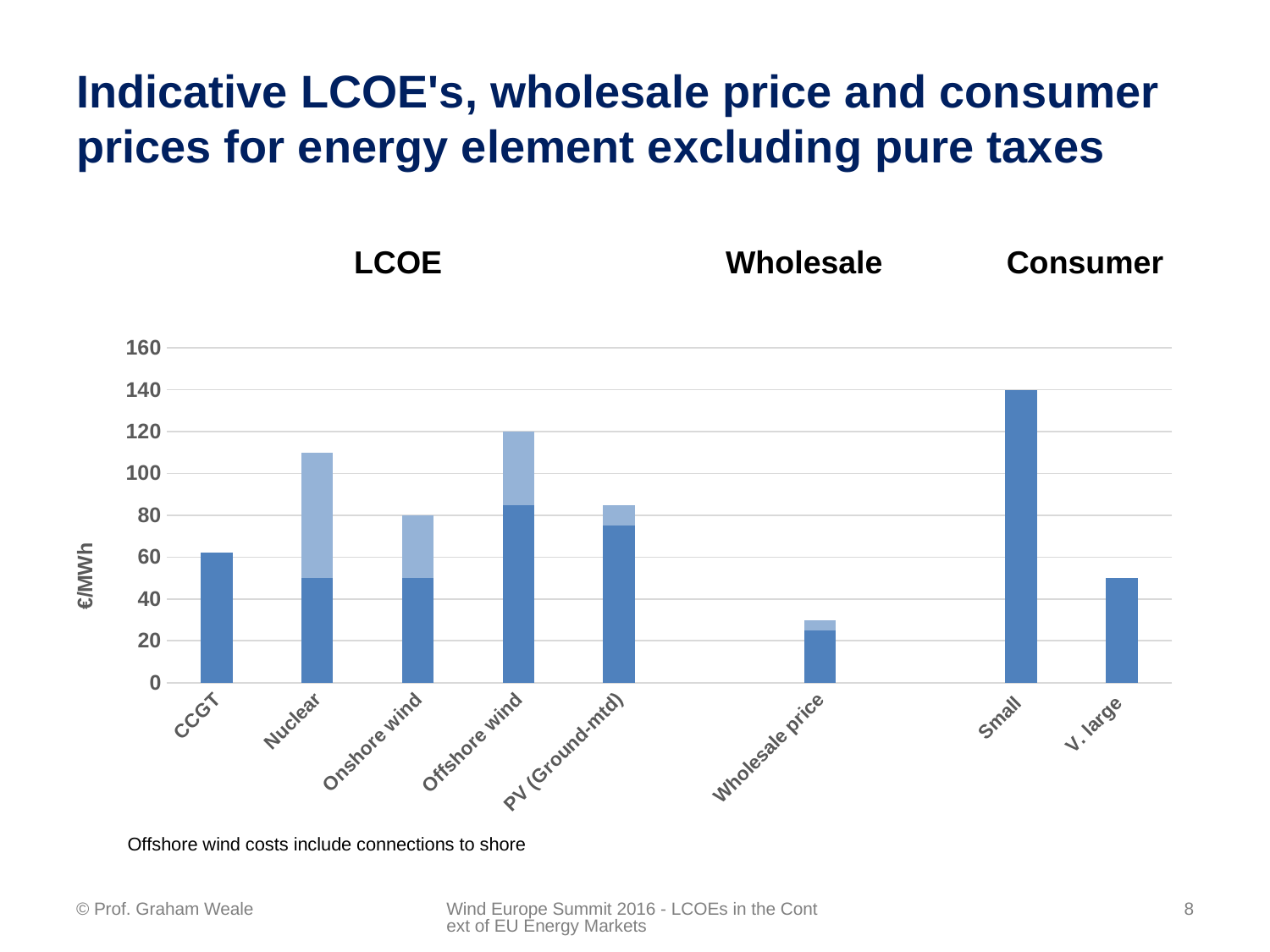
What is the total height of the Offshore wind bar? 120 Is the total value for Wholesale price greater or less than 40? less How many categories are shown along the x axis of the chart? 8 Is the total value for Nuclear greater or less than 100? greater Which category has the highest total bar in the chart? Small What is the value for Small in the chart? 140 What kind of chart is shown on the slide? bar chart Is the value for CCGT greater or less than 80? less Which category has the lowest total bar in the chart? Wholesale price Which has the larger bar, Small or V. large? Small Which has the larger total bar, Nuclear or Onshore wind? Nuclear What unit is shown on the y axis of the chart? €/MWh